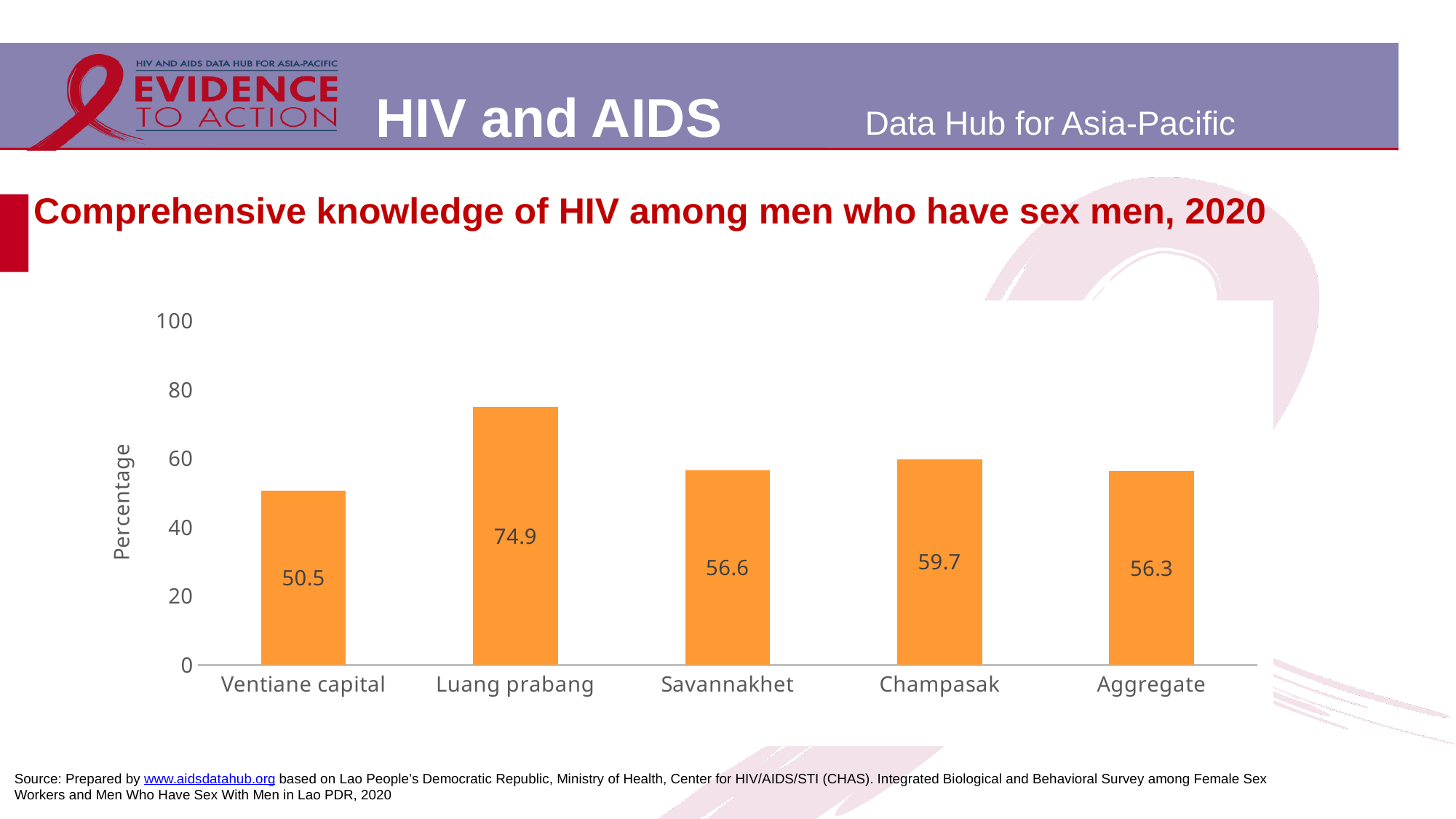
What is the difference between the values for Champasak and Savannakhet? 3.1 Is the value for Luang prabang greater or less than 60? greater What is the Aggregate value shown in the chart? 56.3 What kind of chart is shown on the slide? Bar chart Which is larger, the value for Champasak or the value for Aggregate? Champasak What is the value for Luang prabang? 74.9 What is the value for Champasak? 59.7 What is the difference between the values for Luang prabang and Ventiane capital? 24.4 Which category has the highest value? Luang prabang What is the value for Ventiane capital? 50.5 Which category has the lowest value? Ventiane capital How many categories are shown on the x axis? 5